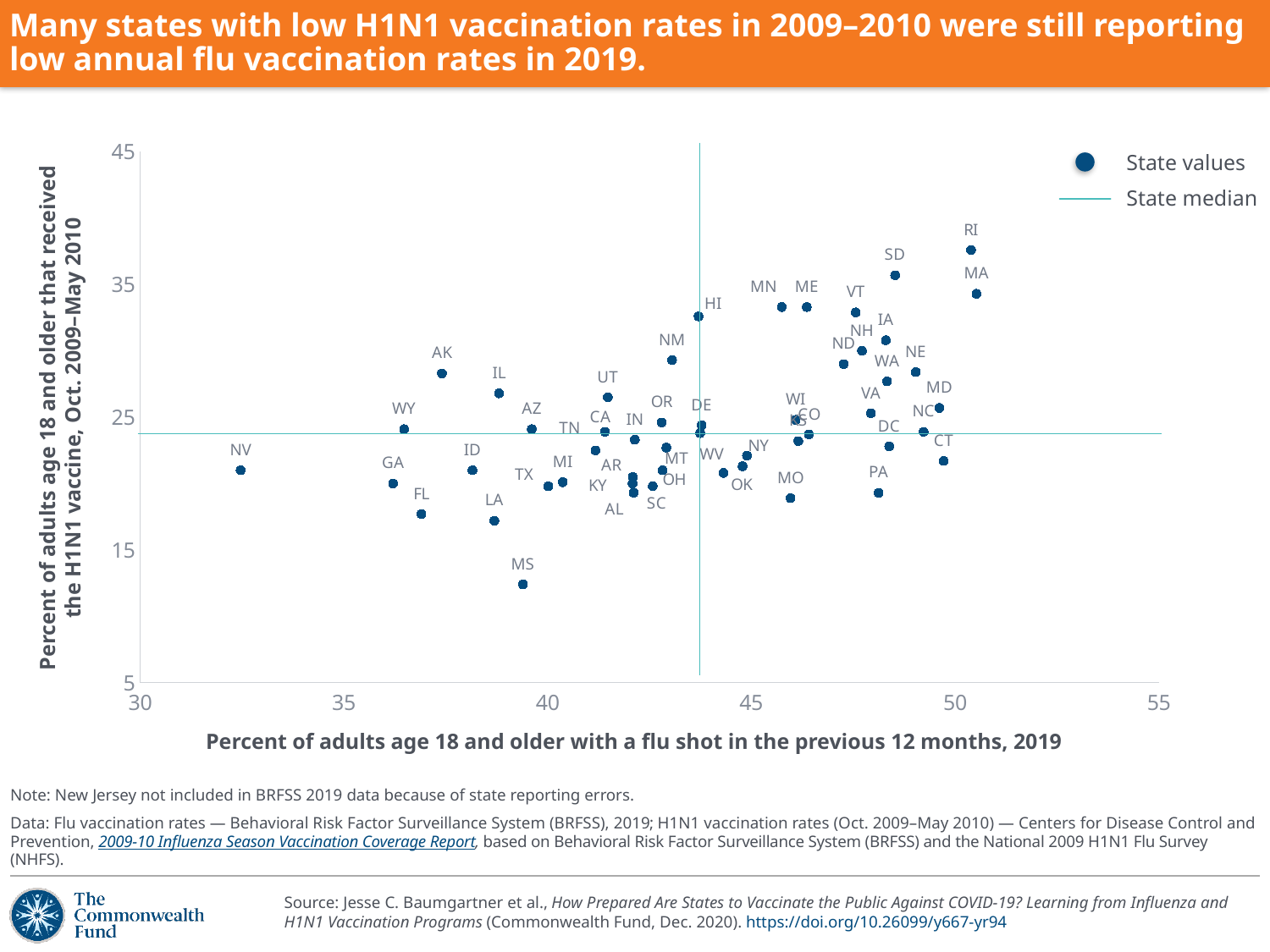
Which state has the highest H1N1 vaccination rate (Oct. 2009–May 2010) on the chart? RI Is the 2019 flu shot rate for NV greater or less than 35? less What kind of chart is shown on the slide? Scatter plot Which state has the lowest 2019 flu shot rate on the chart? NV Is the H1N1 vaccination rate for MS greater or less than 15? less Which state has the lowest H1N1 vaccination rate (Oct. 2009–May 2010) on the chart? MS Is the H1N1 vaccination rate for RI greater or less than 35? greater How many entries does the legend list? 2 What is the title of the x axis? Percent of adults age 18 and older with a flu shot in the previous 12 months, 2019 Which state has the higher H1N1 vaccination rate, AK or FL? AK